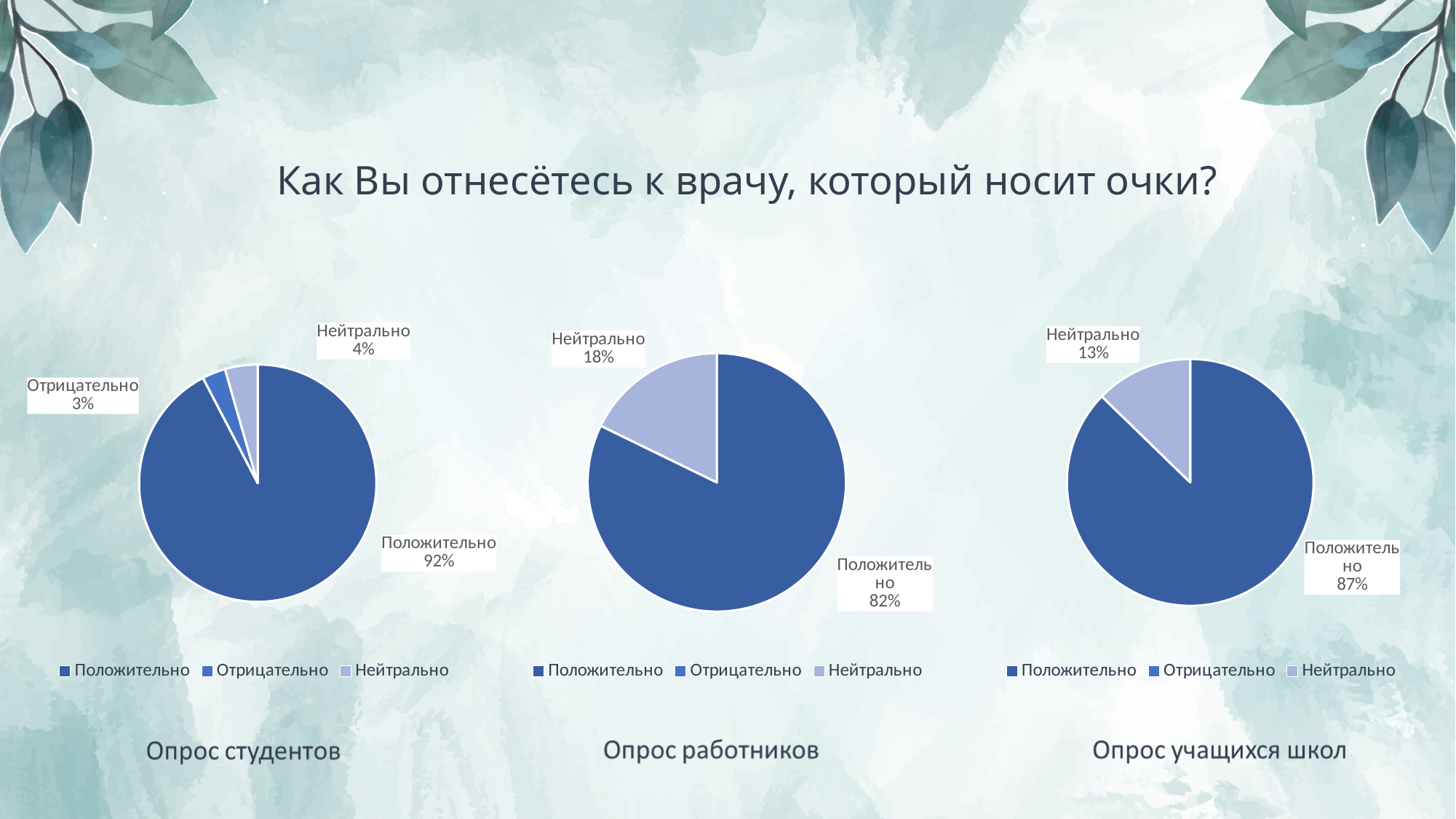
In the pie chart 'Опрос учащихся школ', what share is labelled 'Нейтрально'? 13% How many pie charts are shown on the slide? 3 In the pie chart 'Опрос учащихся школ', what share is labelled 'Положительно'? 87% In the pie chart 'Опрос студентов', what share is labelled 'Положительно'? 92% In the pie chart 'Опрос студентов', which labelled category has the smallest slice? Отрицательно What type of chart is used for 'Опрос студентов'? Pie chart What is the difference between the 'Положительно' shares in the 'Опрос студентов' chart and the 'Опрос работников' chart? 10% In the pie chart 'Опрос работников', which category has the largest slice? Положительно Which is larger: the 'Нейтрально' share in 'Опрос работников' or in 'Опрос учащихся школ'? Опрос работников How many entries does the legend of the 'Опрос работников' chart list? 3 In the pie chart 'Опрос работников', what share is labelled 'Нейтрально'? 18% In the pie chart 'Опрос студентов', what share is labelled 'Отрицательно'? 3%